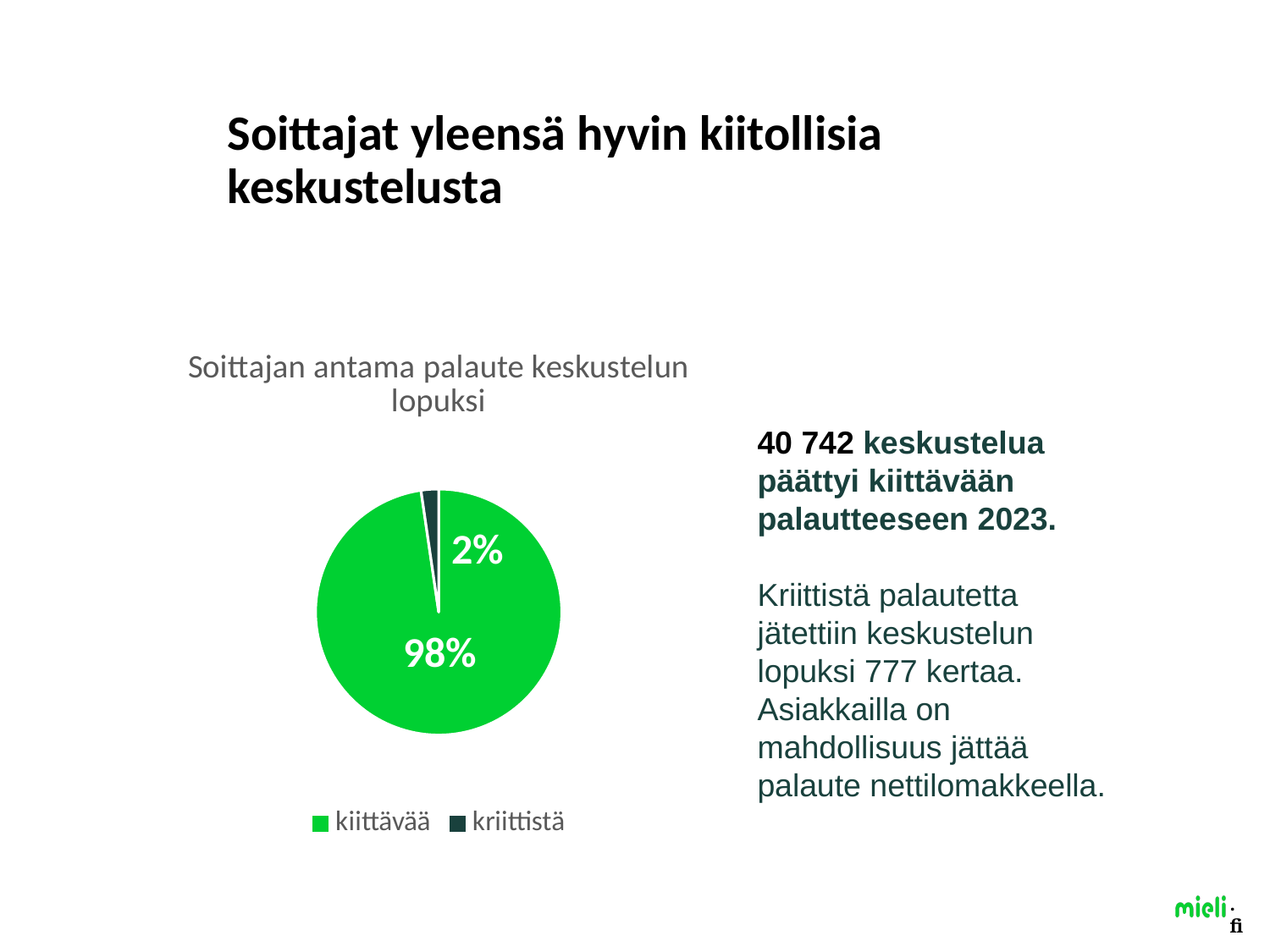
What is the difference in percentage points between the "kiittävää" and "kriittistä" slices? 96 percentage points Which slice is larger, "kiittävää" or "kriittistä"? kiittävää What is the title of the chart? Soittajan antama palaute keskustelun lopuksi What share of the pie is labelled "kiittävää"? 98% What share of the pie is labelled "kriittistä"? 2% How many entries does the legend list? 2 Which category has the largest slice of the pie? kiittävää What kind of chart is shown on the slide? pie chart Which category has the smallest slice of the pie? kriittistä How many categories does the pie chart show? 2 Which colour represents "kriittistä" in the pie chart? dark green